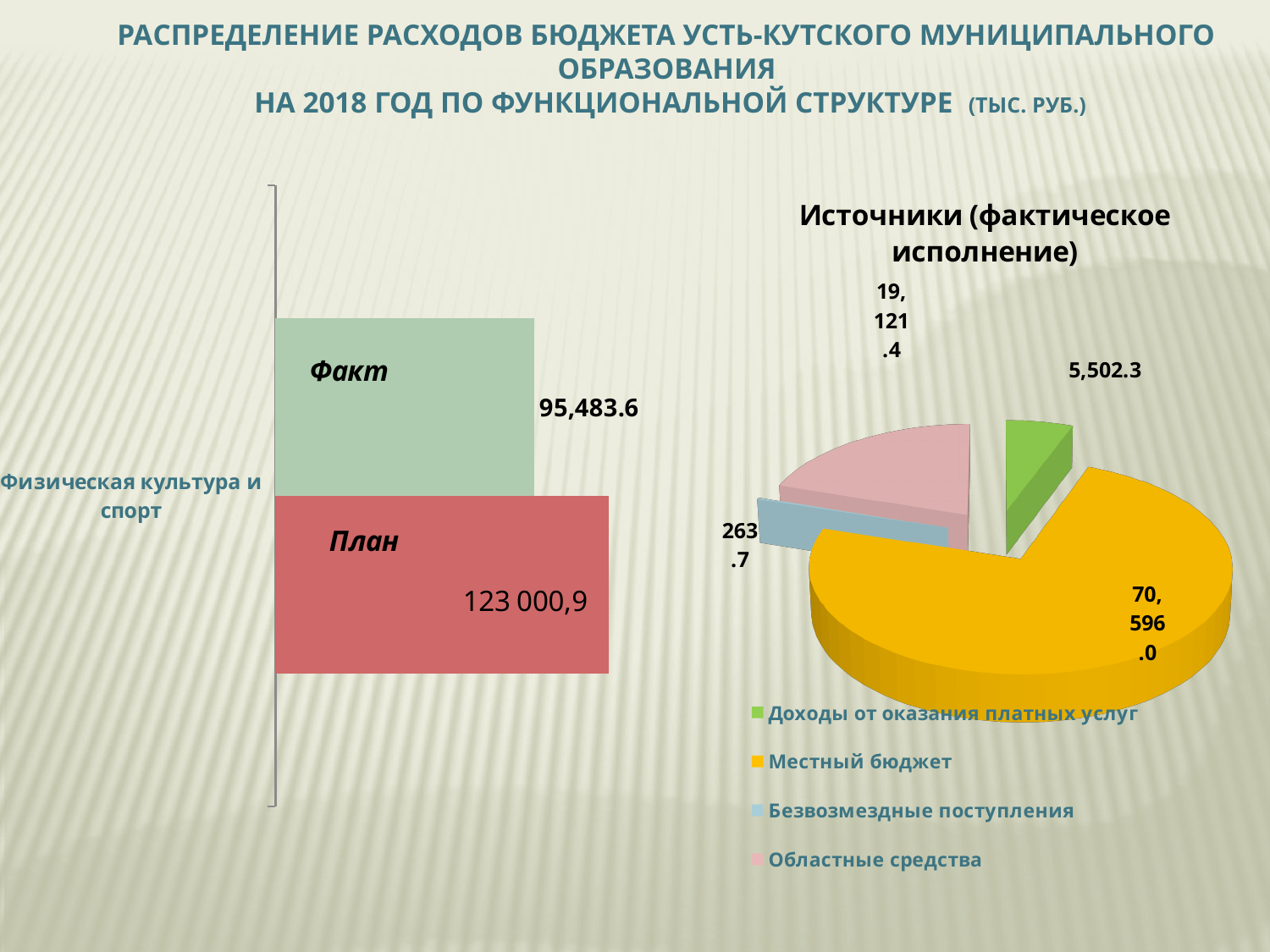
In the pie chart 'Источники (фактическое исполнение)', what is the value for Областные средства? 19,121.4 In the bar chart on the left, which is larger, Факт or План? План In the pie chart 'Источники (фактическое исполнение)', which source has the largest value? Местный бюджет In the bar chart on the left, what is the value for Факт? 95,483.6 In the bar chart on the left, what is the value for План? 123 000,9 In the pie chart 'Источники (фактическое исполнение)', how many sources does the legend list? 4 What kind of chart is the chart on the left of the slide? bar chart In the bar chart on the left, what is the difference between План and Факт? 27,517.3 In the pie chart 'Источники (фактическое исполнение)', what is the difference between Местный бюджет and Областные средства? 51,474.6 In the pie chart 'Источники (фактическое исполнение)', what is the value for Безвозмездные поступления? 263.7 In the pie chart 'Источники (фактическое исполнение)', which source has the smallest value? Безвозмездные поступления In the pie chart 'Источники (фактическое исполнение)', what is the value for Местный бюджет? 70,596.0